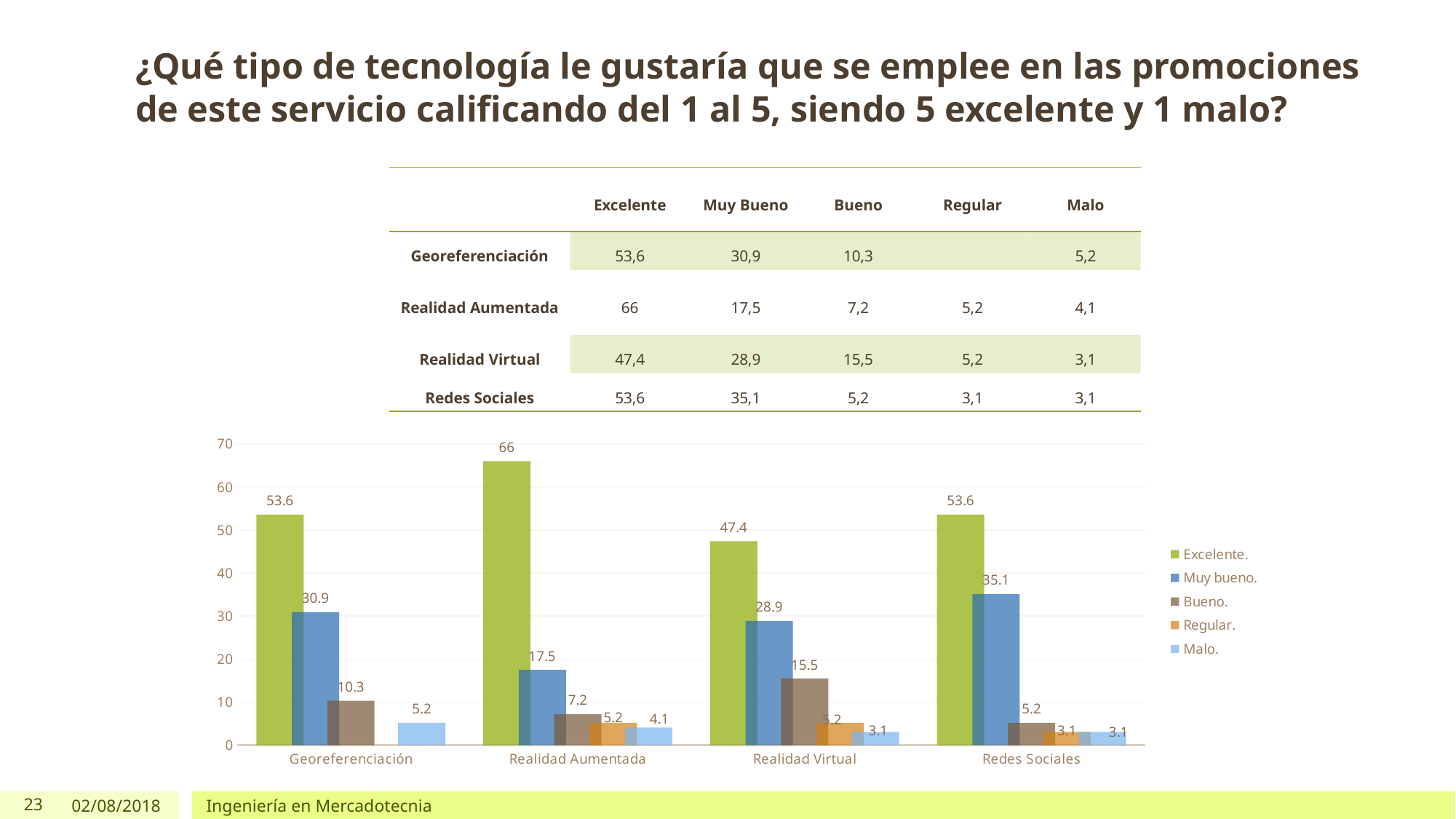
What is the difference between the Excelente values for Realidad Aumentada and Realidad Virtual in the chart? 18.6 Is the Excelente value for Georeferenciación greater or less than 50? greater What is the Excelente value for Realidad Aumentada in the chart? 66 Which category has the highest Excelente value in the chart? Realidad Aumentada What is the Muy bueno value for Redes Sociales in the chart? 35.1 How many series does the chart legend list? 5 Which category has the lowest Excelente value in the chart? Realidad Virtual Which is larger in the chart: the Muy bueno value for Georeferenciación or for Realidad Aumentada? Georeferenciación Which legend entry is shown in green in the chart? Excelente. What type of chart is shown on the slide? bar chart How many categories are shown on the x axis of the chart? 4 What is the Bueno value for Realidad Virtual in the chart? 15.5